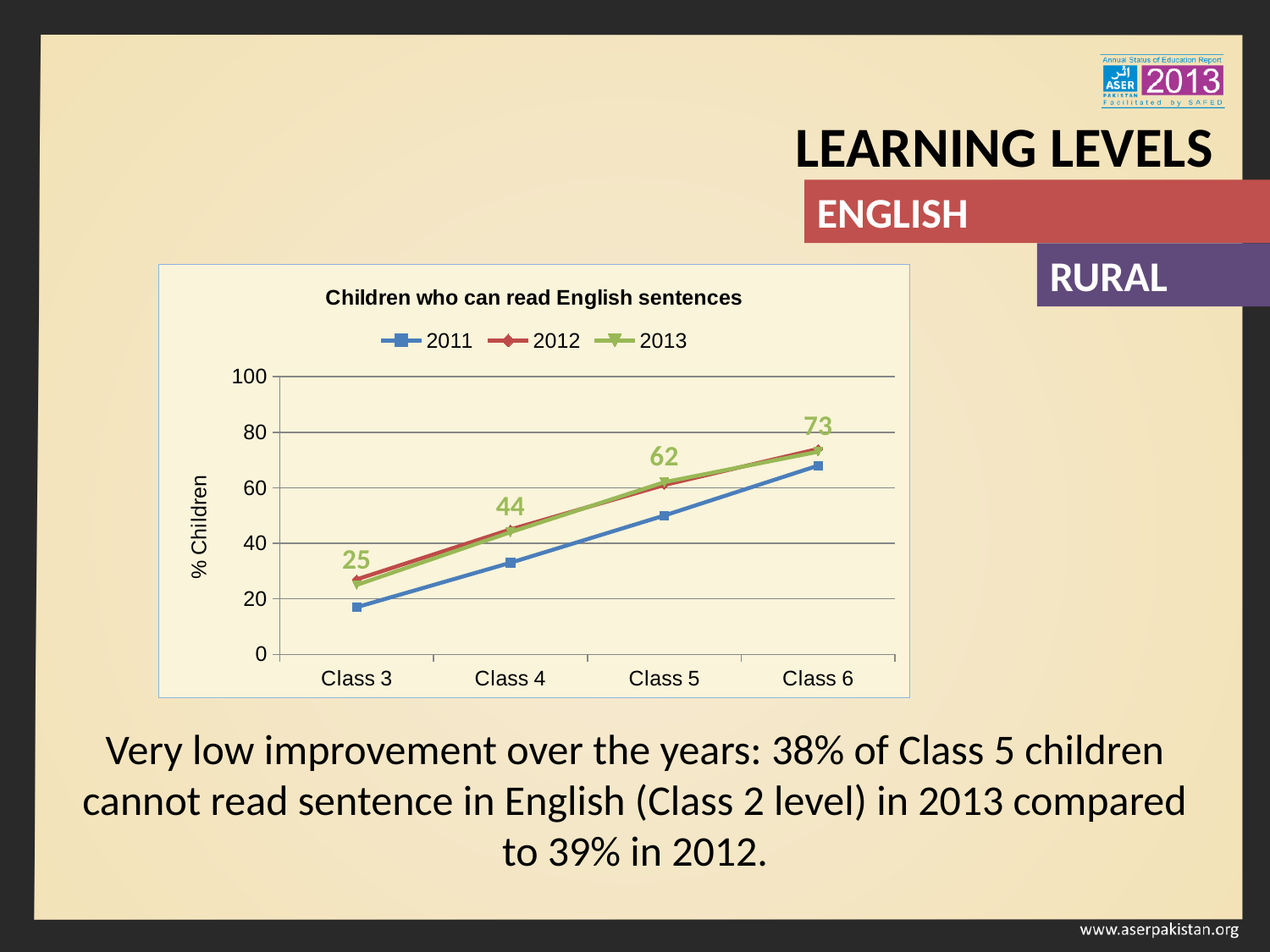
At Class 3, which series has the larger value, 2011 or 2013? 2013 What is the value for the 2013 series at Class 6? 73 Is the value for the 2011 series at Class 3 greater or less than 20? less Do the values in the 2013 series rise or fall from Class 3 to Class 6? Rise Which class has the lowest value in the 2013 series? Class 3 How many series does the legend list? 3 What is the difference between the 2013 values for Class 6 and Class 4? 29 What is the value for the 2013 series at Class 3? 25 What kind of chart is shown on the slide? Line chart Is the value for the 2011 series at Class 6 greater or less than 60? greater What is the value for the 2013 series at Class 5? 62 Which class has the highest value in the 2013 series? Class 6